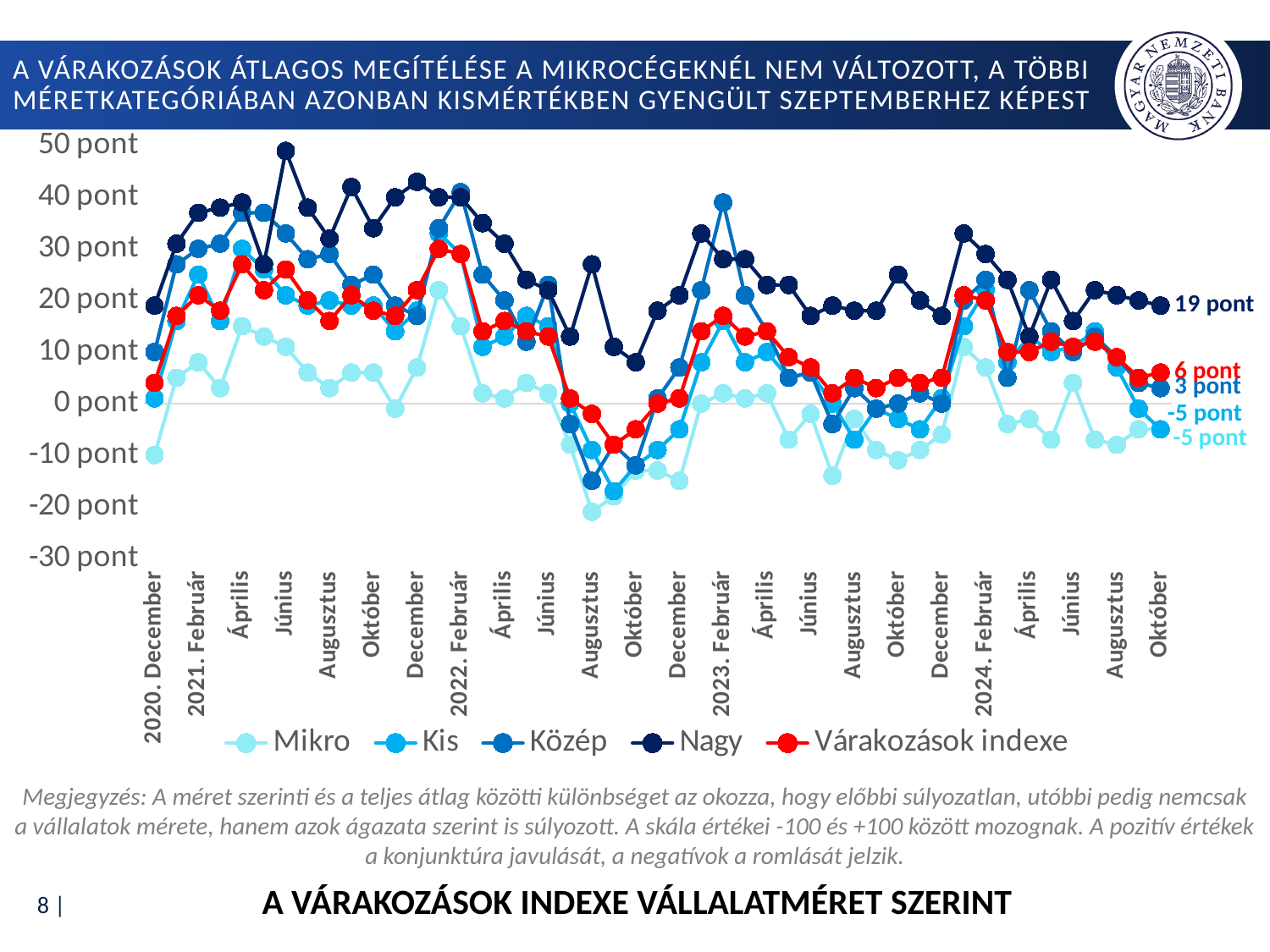
What is the value of the Közép series at the last point (Október 2024)? 3 pont What is the value of the Mikro series at the last point (Október 2024)? -5 pont What is the difference between the Nagy and Várakozások indexe values at the last point (Október 2024)? 13 pont Is the value of the Nagy series in Június 2021 greater or less than 40 pont? greater At the last point (Október 2024), which is larger: the Nagy value or the Mikro value? Nagy What is the value of the Várakozások indexe series at the last point (Október 2024)? 6 pont What is the title of the chart shown at the bottom of the slide? A VÁRAKOZÁSOK INDEXE VÁLLALATMÉRET SZERINT Is the value of the Mikro series in Augusztus 2022 greater or less than -10 pont? less What is the value of the Nagy series at the last point (Október 2024)? 19 pont What kind of chart is shown on the slide? Line chart How many series does the legend list? 5 Which series has the highest value at the last point (Október 2024)? Nagy